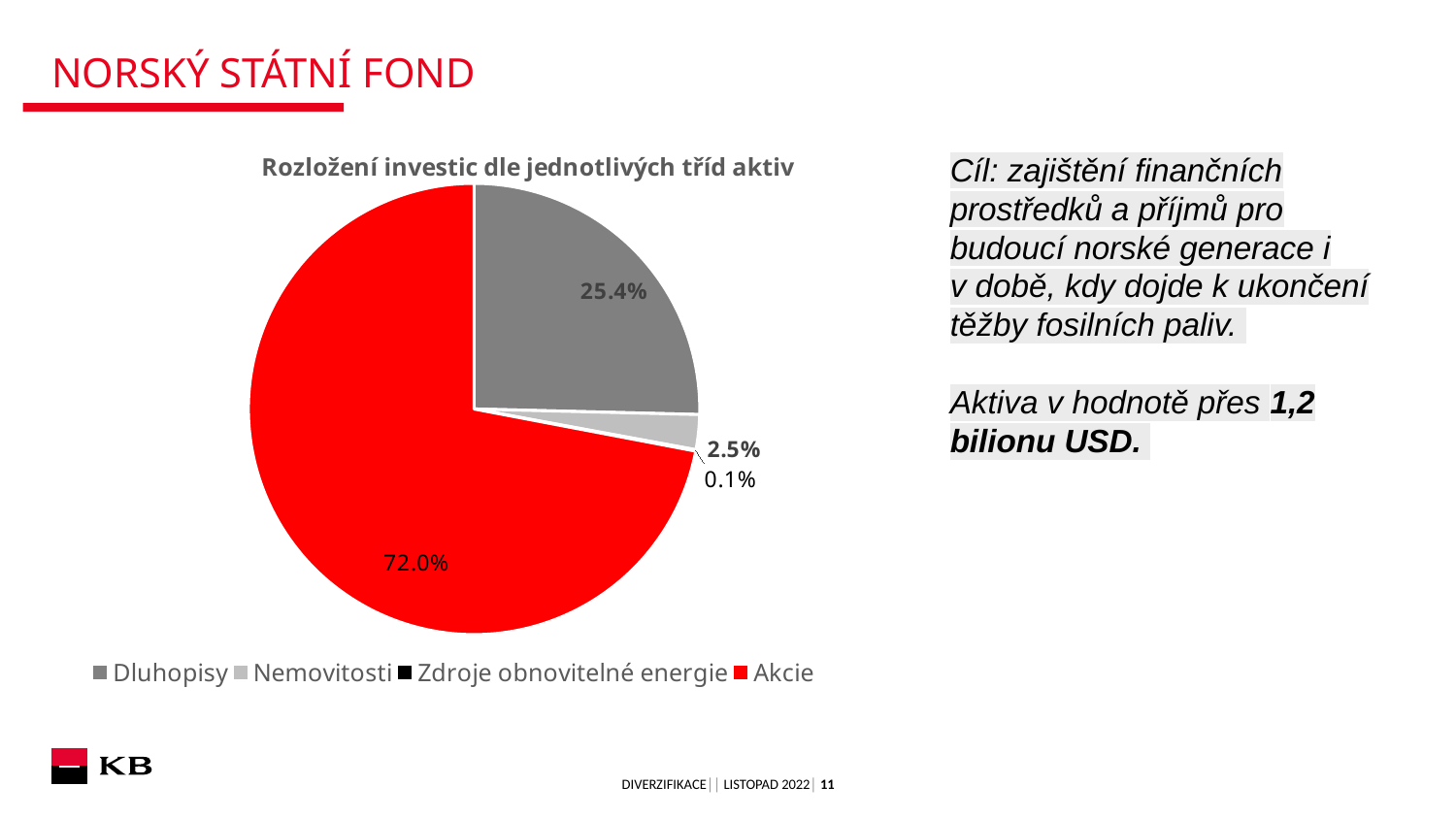
Which category has the smallest slice of the pie? Zdroje obnovitelné energie Which category has the largest slice of the pie? Akcie What colour is the Akcie slice? red What share of the pie does Nemovitosti represent? 2.5% How many categories does the legend list? 4 What type of chart is shown on the slide? pie chart Which is larger, the share for Dluhopisy or the share for Nemovitosti? Dluhopisy What share of the pie does Akcie represent? 72.0% What is the title of the chart? Rozložení investic dle jednotlivých tříd aktiv What share of the pie does Zdroje obnovitelné energie represent? 0.1% What share of the pie does Dluhopisy represent? 25.4% What is the difference in percentage points between Akcie and Dluhopisy? 46.6